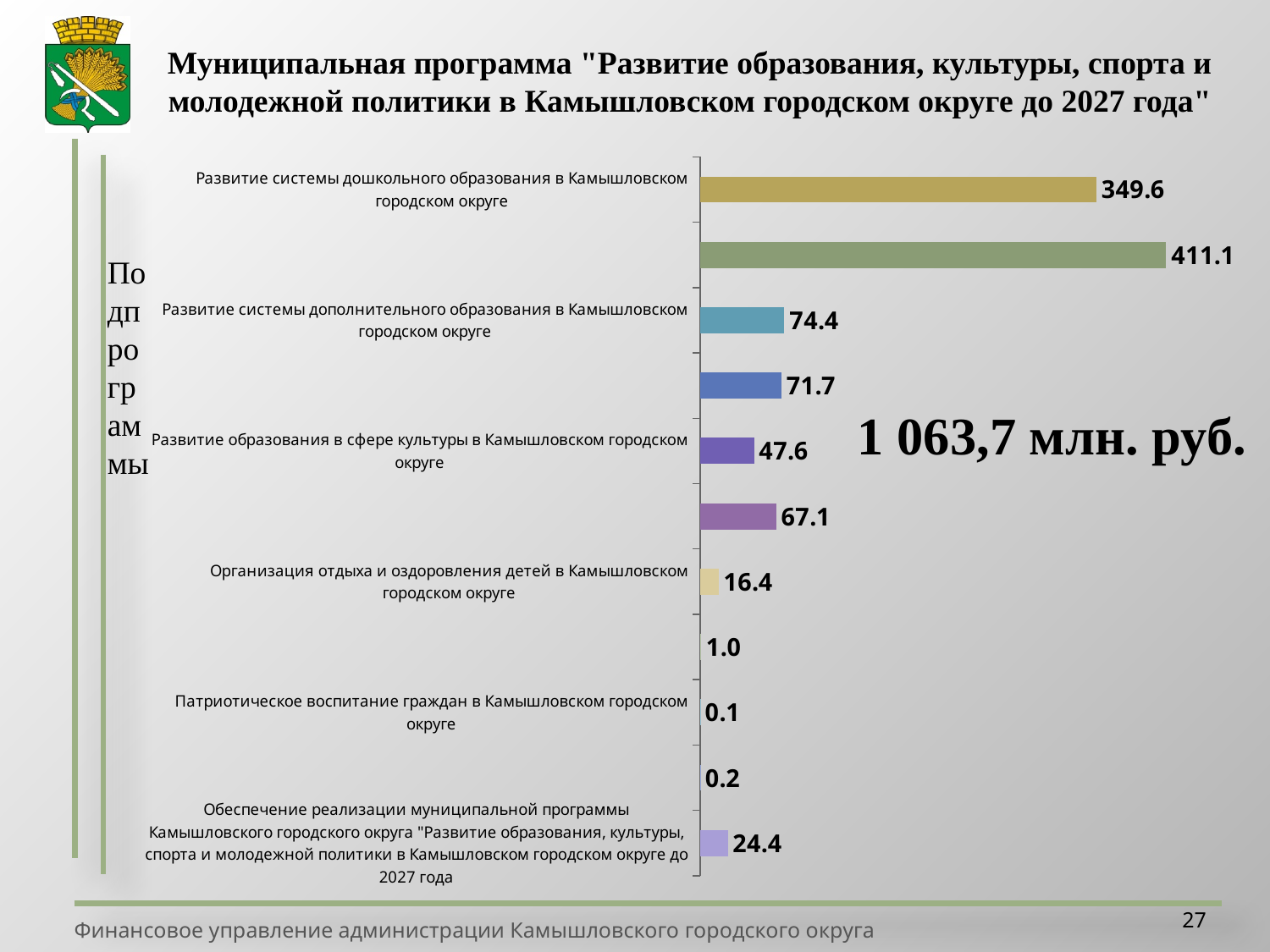
What is the value for "Развитие образования в сфере культуры в Камышловском городском округе"? 47.6 What total amount is printed in large text next to the chart? 1 063,7 млн. руб. Which labelled category has the lowest value? Патриотическое воспитание граждан в Камышловском городском округе What is the value for "Организация отдыха и оздоровления детей в Камышловском городском округе"? 16.4 What kind of chart is shown on the slide? bar chart What is the value for "Патриотическое воспитание граждан в Камышловском городском округе"? 0.1 What is the largest value labelled on the chart? 411.1 What is the difference between the values for "Развитие системы дошкольного образования" and "Развитие системы дополнительного образования"? 275.2 How many bars are plotted on the chart? 11 Which is larger: the value for "Обеспечение реализации муниципальной программы..." or for "Организация отдыха и оздоровления детей..."? Обеспечение реализации муниципальной программы... What is the value for "Развитие системы дошкольного образования в Камышловском городском округе"? 349.6 What is the value for "Развитие системы дополнительного образования в Камышловском городском округе"? 74.4